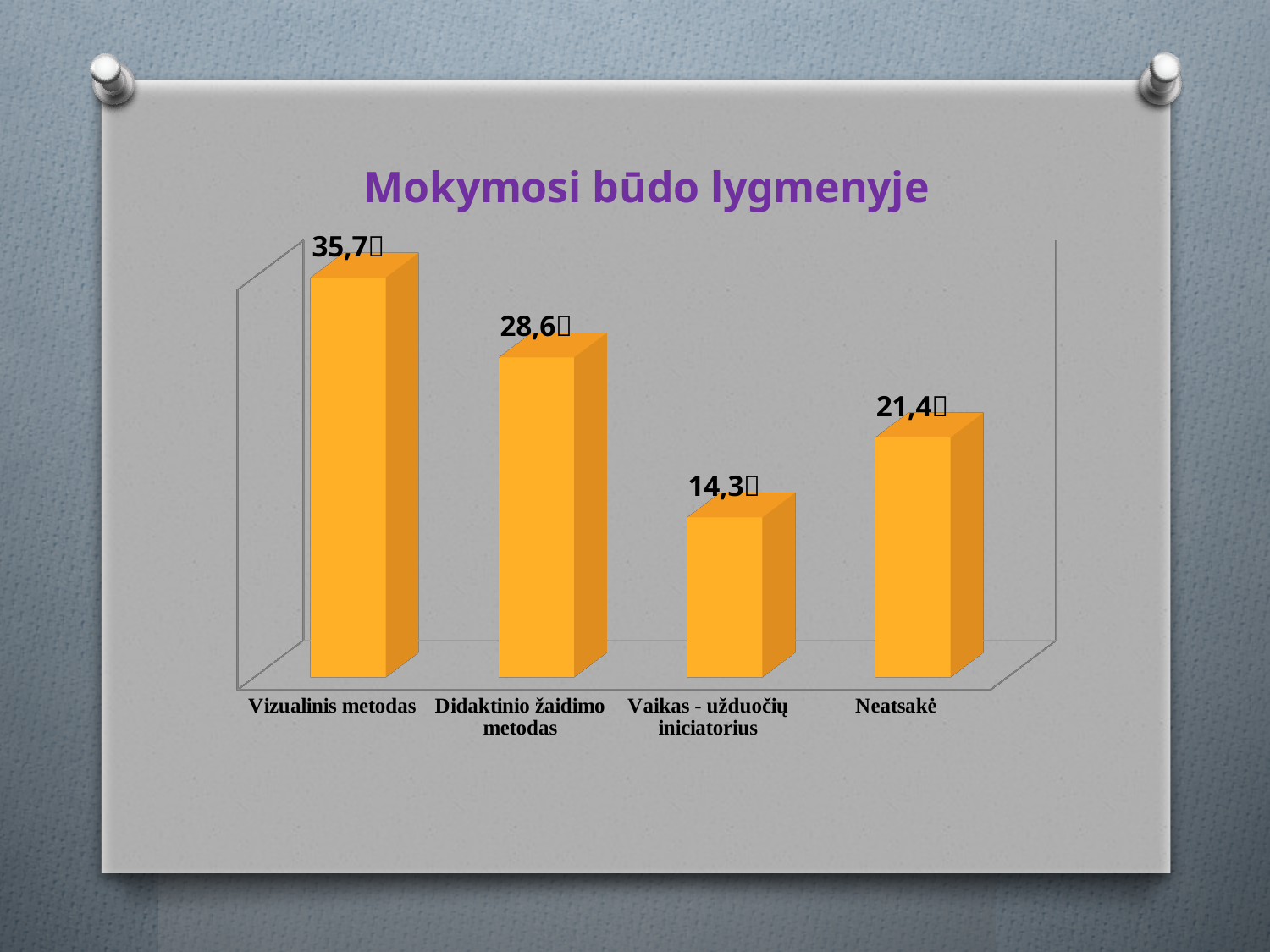
What is the value shown for Didaktinio žaidimo metodas? 28,6 Which is larger, the value for Neatsakė or the value for Didaktinio žaidimo metodas? Didaktinio žaidimo metodas How many categories are shown in the chart? 4 What is the value shown for Vizualinis metodas? 35,7 What kind of chart is shown on the slide? Bar chart Which category has the highest value? Vizualinis metodas What is the value shown for Neatsakė? 21,4 What is the value shown for Vaikas - užduočių iniciatorius? 14,3 What is the title of the chart? Mokymosi būdo lygmenyje What is the difference between the values for Neatsakė and Vaikas - užduočių iniciatorius? 7,1 What is the difference between the values for Vizualinis metodas and Didaktinio žaidimo metodas? 7,1 Which category has the lowest value? Vaikas - užduočių iniciatorius